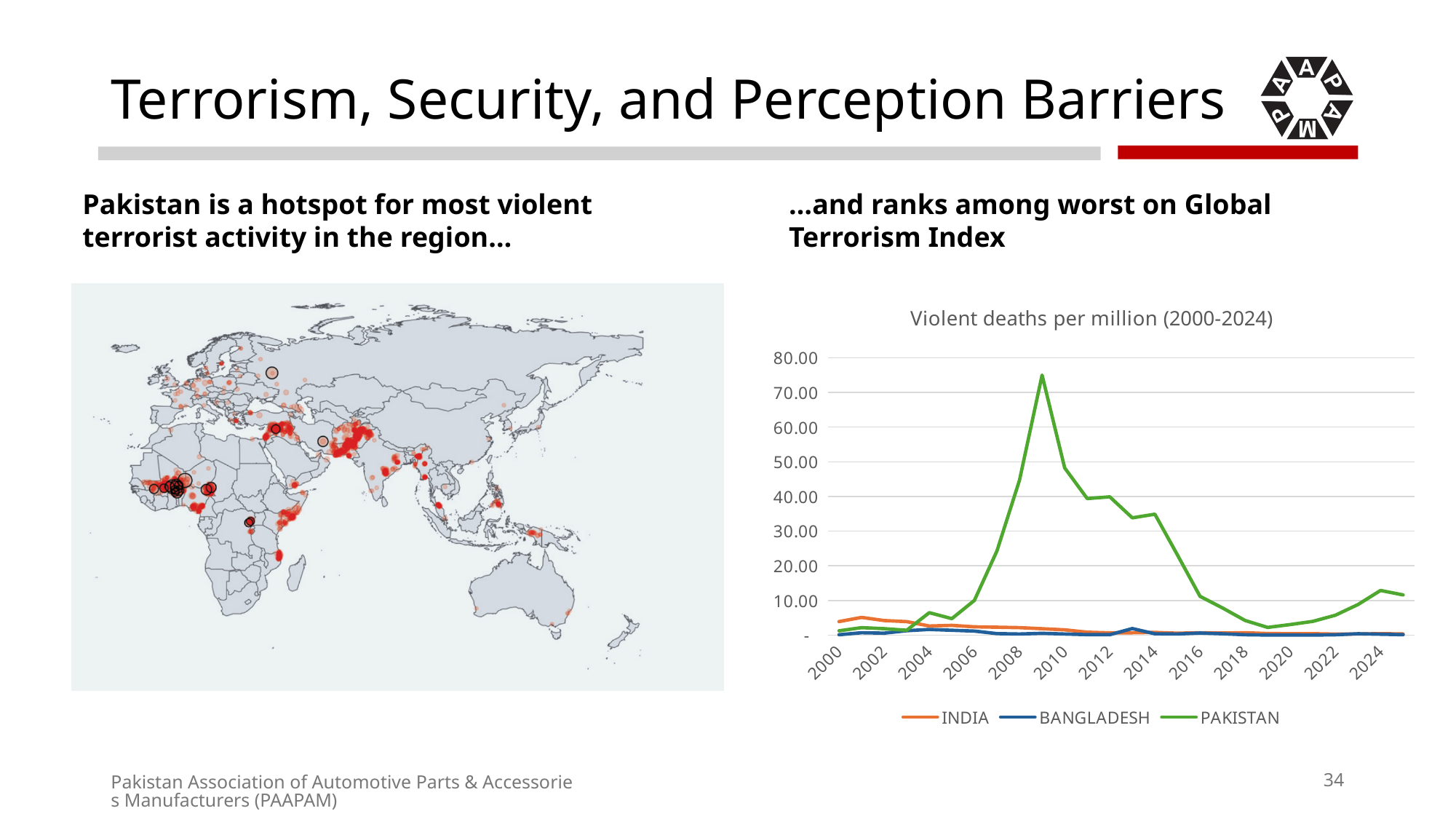
How many series does the legend of the 'Violent deaths per million (2000-2024)' chart list? 3 What is the title of the line chart on the right of the slide? Violent deaths per million (2000-2024) In the 'Violent deaths per million (2000-2024)' chart, which series reaches the highest value? PAKISTAN In the 'Violent deaths per million (2000-2024)' chart, which is larger in 2010: the value for PAKISTAN or the value for INDIA? PAKISTAN In the 'Violent deaths per million (2000-2024)' chart, does the PAKISTAN line rise or fall between 2020 and 2024? rise Which countries are listed in the legend of the 'Violent deaths per million (2000-2024)' chart? INDIA, BANGLADESH, PAKISTAN In the 'Violent deaths per million (2000-2024)' chart, is the peak value for PAKISTAN greater or less than 70.00? greater In the 'Violent deaths per million (2000-2024)' chart, does the PAKISTAN line rise or fall between 2010 and 2018? fall In the 'Violent deaths per million (2000-2024)' chart, is the value for PAKISTAN in 2010 greater or less than 40.00? greater What kind of chart is the 'Violent deaths per million (2000-2024)' chart? line chart In the 'Violent deaths per million (2000-2024)' chart, is the value for PAKISTAN in 2016 greater or less than 20.00? less